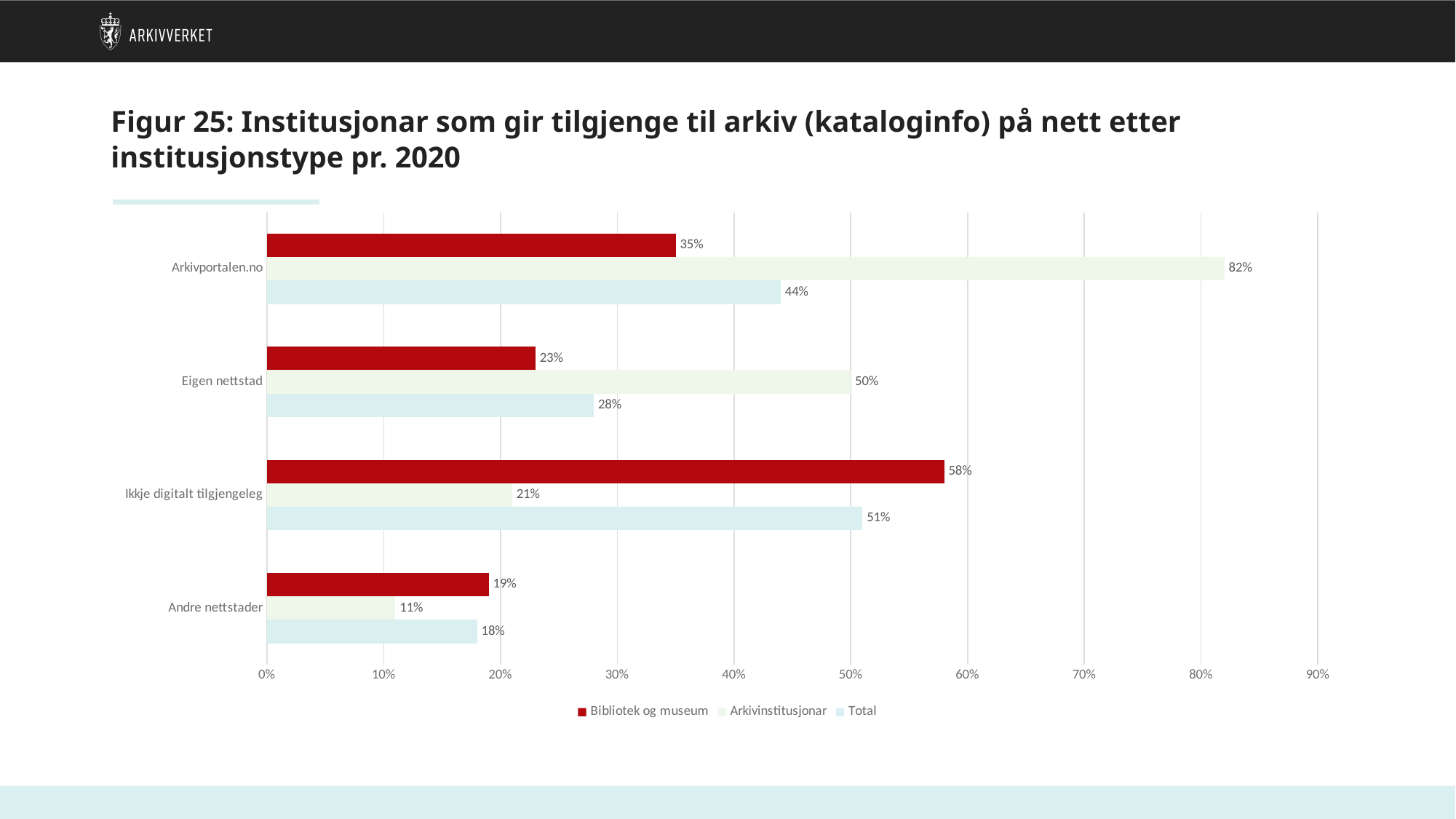
What is the value for Arkivinstitusjonar in the Arkivportalen.no category? 82% How many series does the legend list? 3 How many categories are shown on the chart? 4 Which category has the highest value for the Bibliotek og museum series? Ikkje digitalt tilgjengeleg Which series is shown in red? Bibliotek og museum Which category has the lowest value for the Total series? Andre nettstader What is the Total value for Eigen nettstad? 28% What kind of chart is shown on the slide? Bar chart What is the difference between the Arkivinstitusjonar and Bibliotek og museum values for Arkivportalen.no? 47% What is the value for Bibliotek og museum in the Ikkje digitalt tilgjengeleg category? 58% Which is larger for Eigen nettstad: Bibliotek og museum or Arkivinstitusjonar? Arkivinstitusjonar What is the value for Arkivinstitusjonar in the Andre nettstader category? 11%